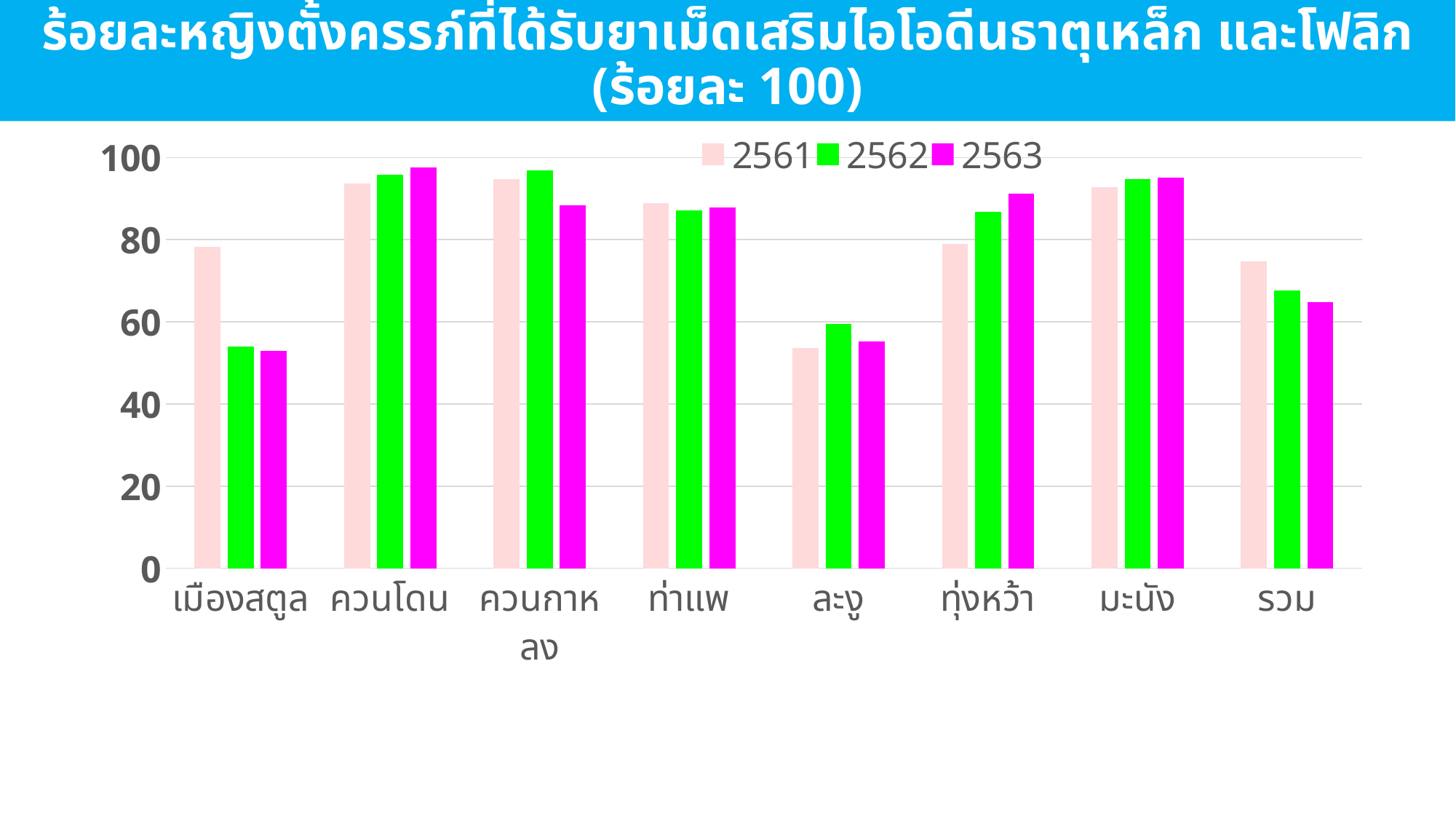
For เมืองสตูล, which is larger: the value for 2561 or the value for 2562? 2561 Is the value for รวม in 2561 greater or less than 80? less Is the value for ละงู in 2561 greater or less than 60? less For รวม, do the values rise or fall from 2561 to 2563? fall For ทุ่งหว้า, which is larger: the value for 2561 or the value for 2563? 2563 Is the value for เมืองสตูล in 2562 greater or less than 60? less How many categories are shown on the x axis? 8 What kind of chart is shown on the slide? bar chart How many series does the legend list? 3 Which years are listed in the legend? 2561, 2562, 2563 Which category has the lowest value for 2561? ละงู